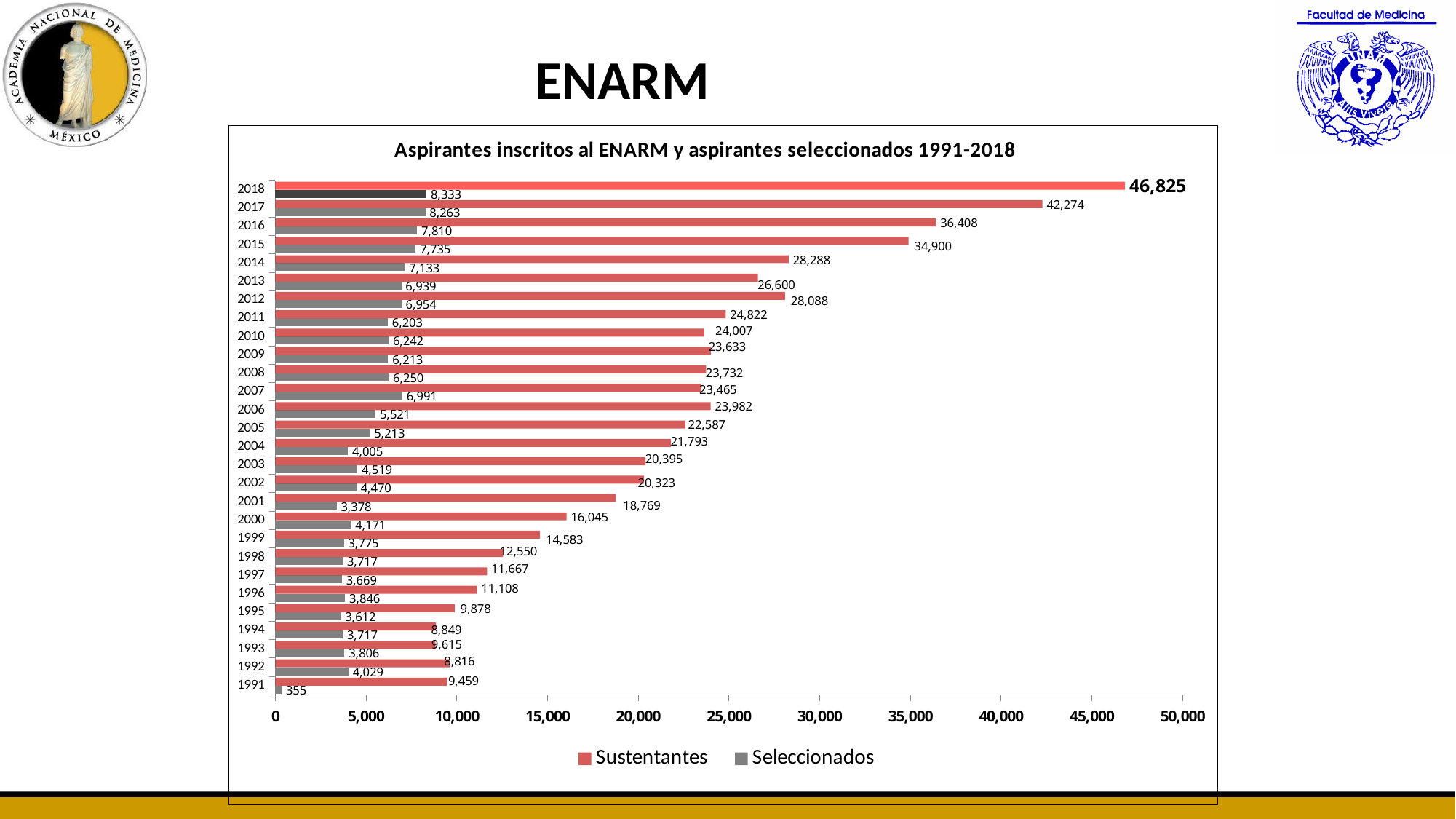
How many series does the legend list? 2 How many years are shown on the chart? 28 Which year has the lowest Seleccionados value? 1991 What is the Sustentantes value for 2018? 46,825 Which year has the larger Sustentantes value, 2012 or 2013? 2012 What is the Seleccionados value for 2015? 7,735 What is the title of the chart? Aspirantes inscritos al ENARM y aspirantes seleccionados 1991-2018 What is the Seleccionados value for 1991? 355 Which year has the highest Sustentantes value? 2018 What is the Sustentantes value for 2010? 24,007 What is the difference between Sustentantes and Seleccionados in 2018? 38,492 What kind of chart is shown on the slide? Bar chart